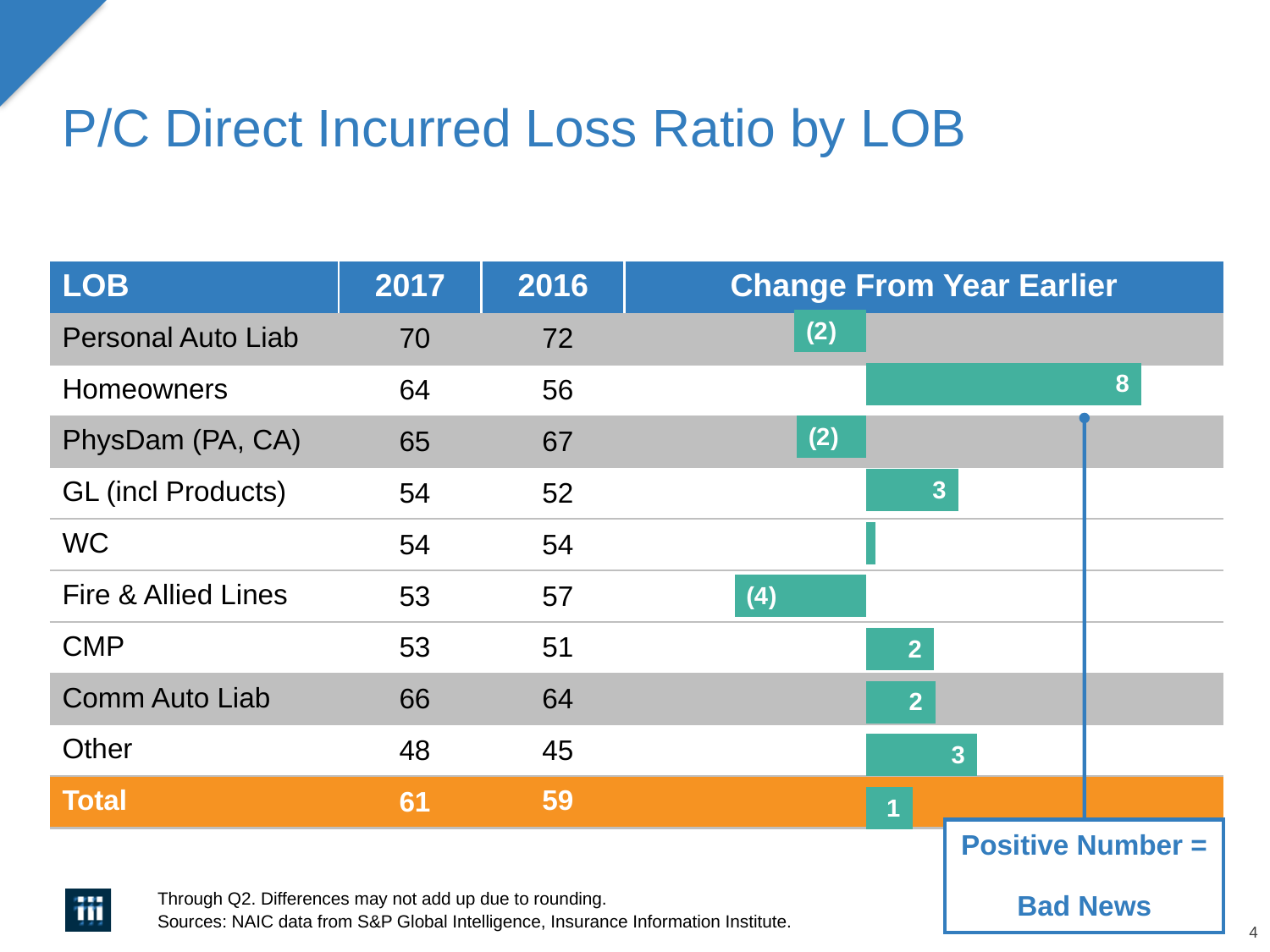
Which line of business has the largest positive change from year earlier? Homeowners What kind of chart is used to show the change from year earlier? Bar chart Which has a larger change from year earlier, Other or CMP? Other According to the note on the slide, what does a positive number mean? Bad News What is the heading of the column containing the bars? Change From Year Earlier What is the change from year earlier shown for Fire & Allied Lines? (4) What is the change from year earlier shown for Personal Auto Liab? (2) Which line of business has the lowest (most negative) change from year earlier? Fire & Allied Lines What is the change from year earlier shown for the Total row? 1 What is the change from year earlier shown for Homeowners? 8 How many lines of business, excluding the Total row, are listed in the chart? 9 What is the difference between the change for Homeowners and the change for GL (incl Products)? 5